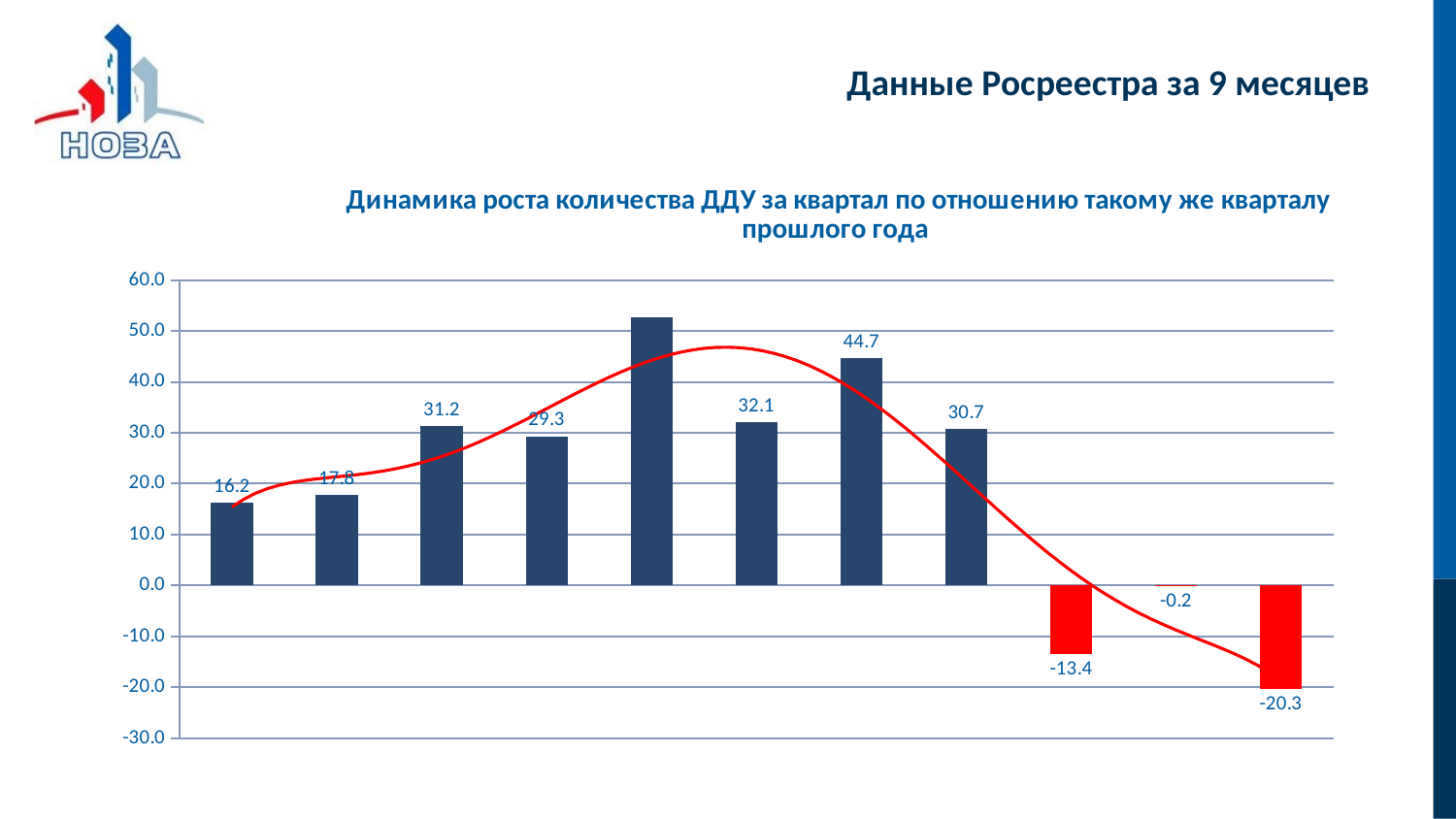
What is the value of the last (rightmost) bar? -20.3 Which bar has the highest value? the fifth bar from the left Is the value of the fifth bar from the left greater or less than 50.0? greater What is the difference between the seventh bar (44.7) and the sixth bar (32.1)? 12.6 What is the value of the first (leftmost) bar? 16.2 How many red bars are visible on the chart? 2 What is the value of the seventh bar from the left? 44.7 What kind of chart is shown on the slide? bar chart Which is larger, the third bar (31.2) or the fourth bar (29.3)? the third bar (31.2) Do the values rise or fall across the first three bars? rise What is the value of the first red bar? -13.4 What is the lowest value shown on the chart? -20.3